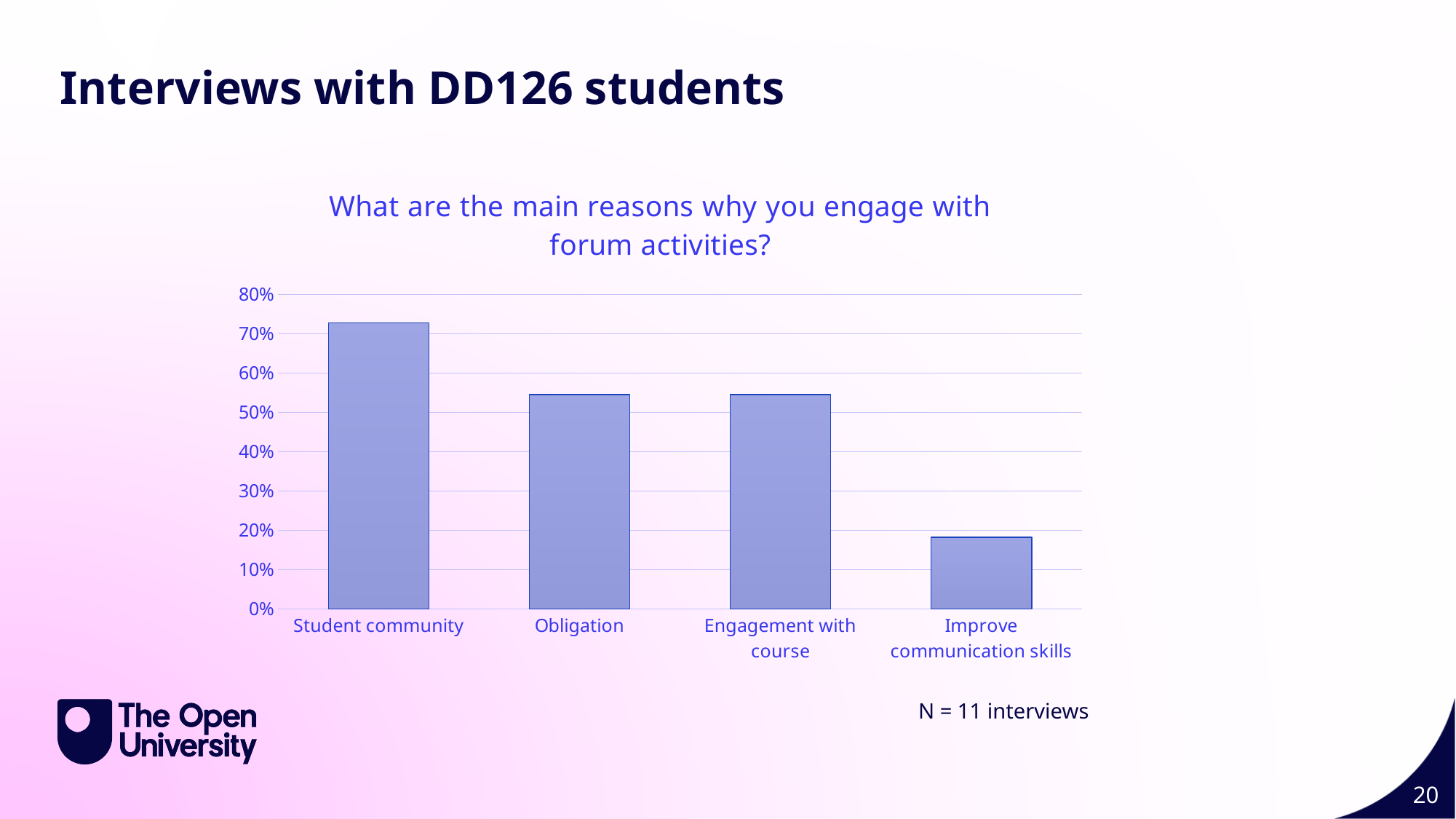
Is the value for Student community greater or less than 70%? greater Which category has the lowest value in the chart? Improve communication skills Which is larger, the value for Engagement with course or the value for Improve communication skills? Engagement with course Is the value for Engagement with course greater or less than 60%? less Is the value for Obligation greater or less than 50%? greater Which is larger, the value for Student community or the value for Obligation? Student community How many categories are shown on the x axis of the chart? 4 How many interviews does the note below the chart say the data is based on? N = 11 interviews Which category has the highest value in the chart? Student community What kind of chart is shown on the slide? bar chart What is the title of the chart? What are the main reasons why you engage with forum activities?